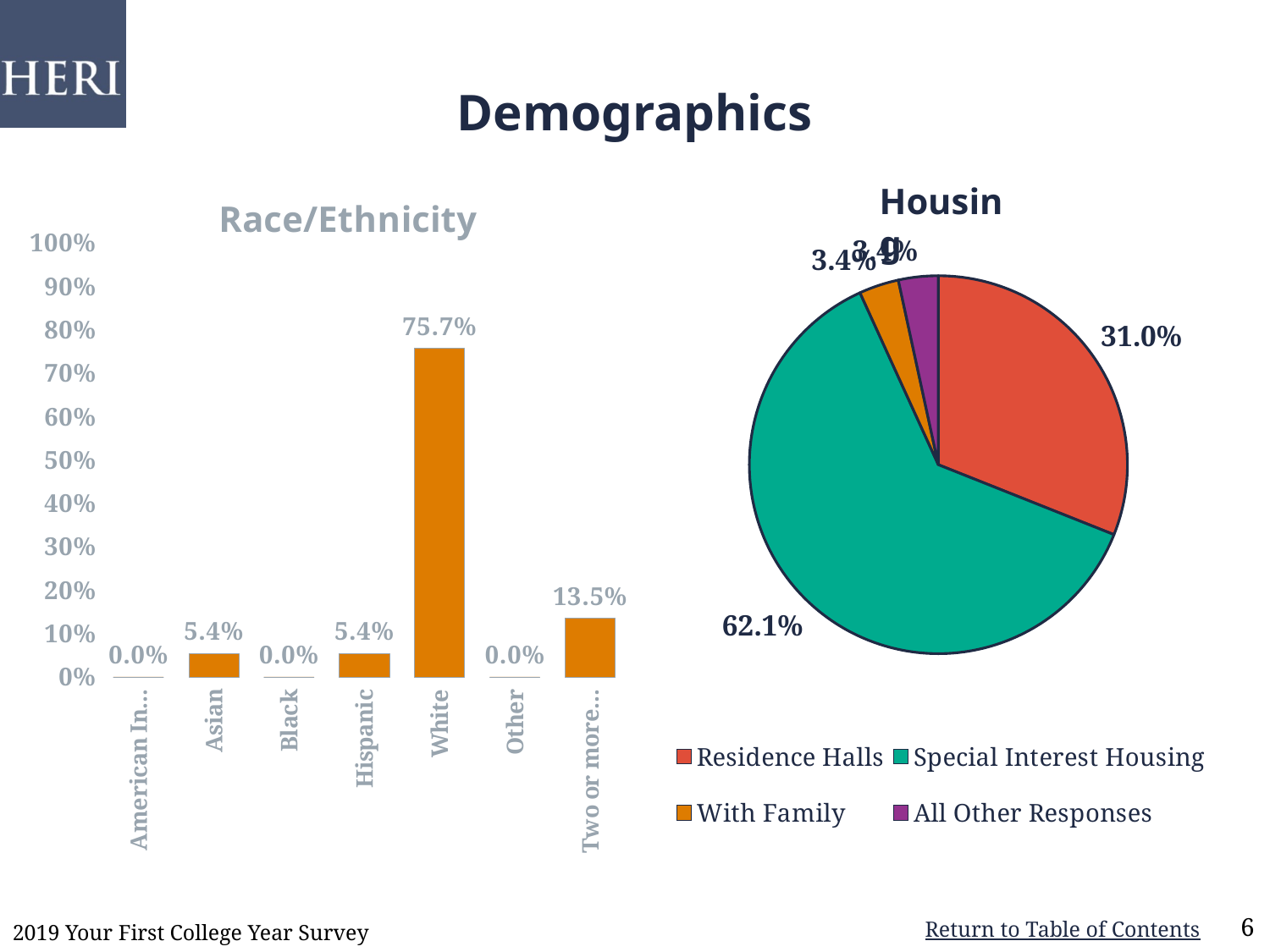
In the Race/Ethnicity bar chart, what is the value for Black? 0.0% In the Race/Ethnicity bar chart, what is the value for Asian? 5.4% In the Housing pie chart, which category has the largest slice? Special Interest Housing What kind of chart is the Race/Ethnicity chart? bar chart In the Race/Ethnicity bar chart, what is the value for White? 75.7% How many entries does the legend of the Housing pie chart list? 4 In the Housing pie chart, what is the share for Residence Halls? 31.0% In the Race/Ethnicity bar chart, what is the difference between the values for White and Hispanic? 70.3% In the Race/Ethnicity bar chart, which category has the highest value? White How many categories are shown in the Race/Ethnicity bar chart? 7 In the Race/Ethnicity bar chart, which is larger, the value for White or the value for Asian? White In the Housing pie chart, what is the share for Special Interest Housing? 62.1%